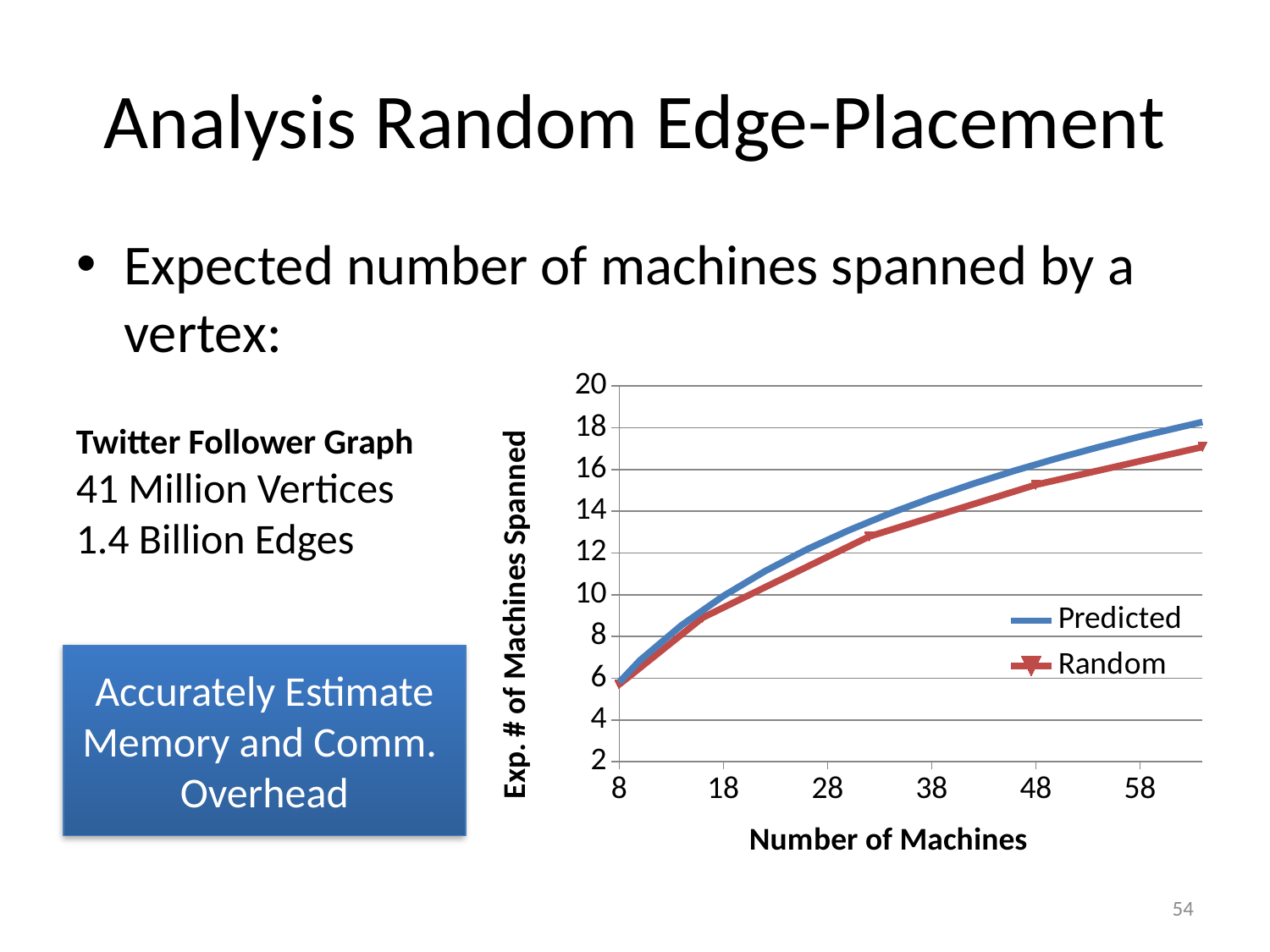
Do the values of the Predicted series rise or fall as the number of machines increases? rise What are the two series named in the chart's legend? Predicted and Random Is the value of the Random series at 48 machines greater or less than 14? greater At 58 machines, which series has the higher value, Predicted or Random? Predicted What kind of chart is shown on the slide? line chart Is the value of the Predicted series at 58 machines greater or less than 16? greater What is the title of the chart's x axis? Number of Machines Is the value of the Random series at 28 machines greater or less than 10? greater At 48 machines, which series has the higher value, Predicted or Random? Predicted How many series does the chart's legend list? 2 Do the values of the Random series rise or fall as the number of machines increases? rise